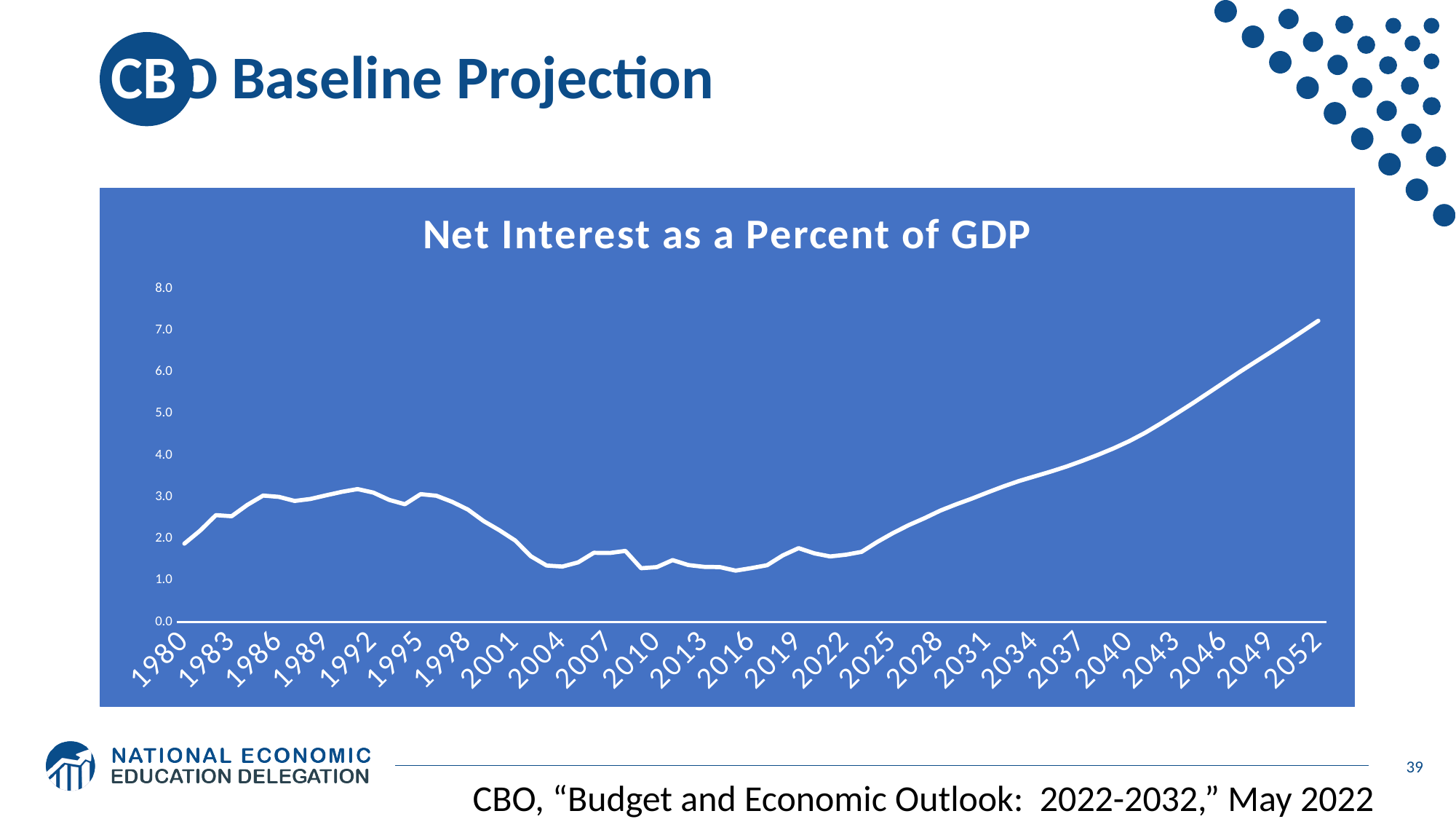
Which year has the larger value, 1980 or 2052? 2052 Is the value for 1992 greater or less than 2.0? greater Which year has the larger value, 1992 or 2004? 1992 In which year does the chart reach its highest value? 2052 What is the highest value shown on the vertical axis? 8.0 Is the value for 2040 greater or less than 3.0? greater Is the value for 1980 greater or less than 3.0? less Does the line rise or fall between 2022 and 2052? rise What is the title of the chart? Net Interest as a Percent of GDP What kind of chart is shown on the slide? line chart